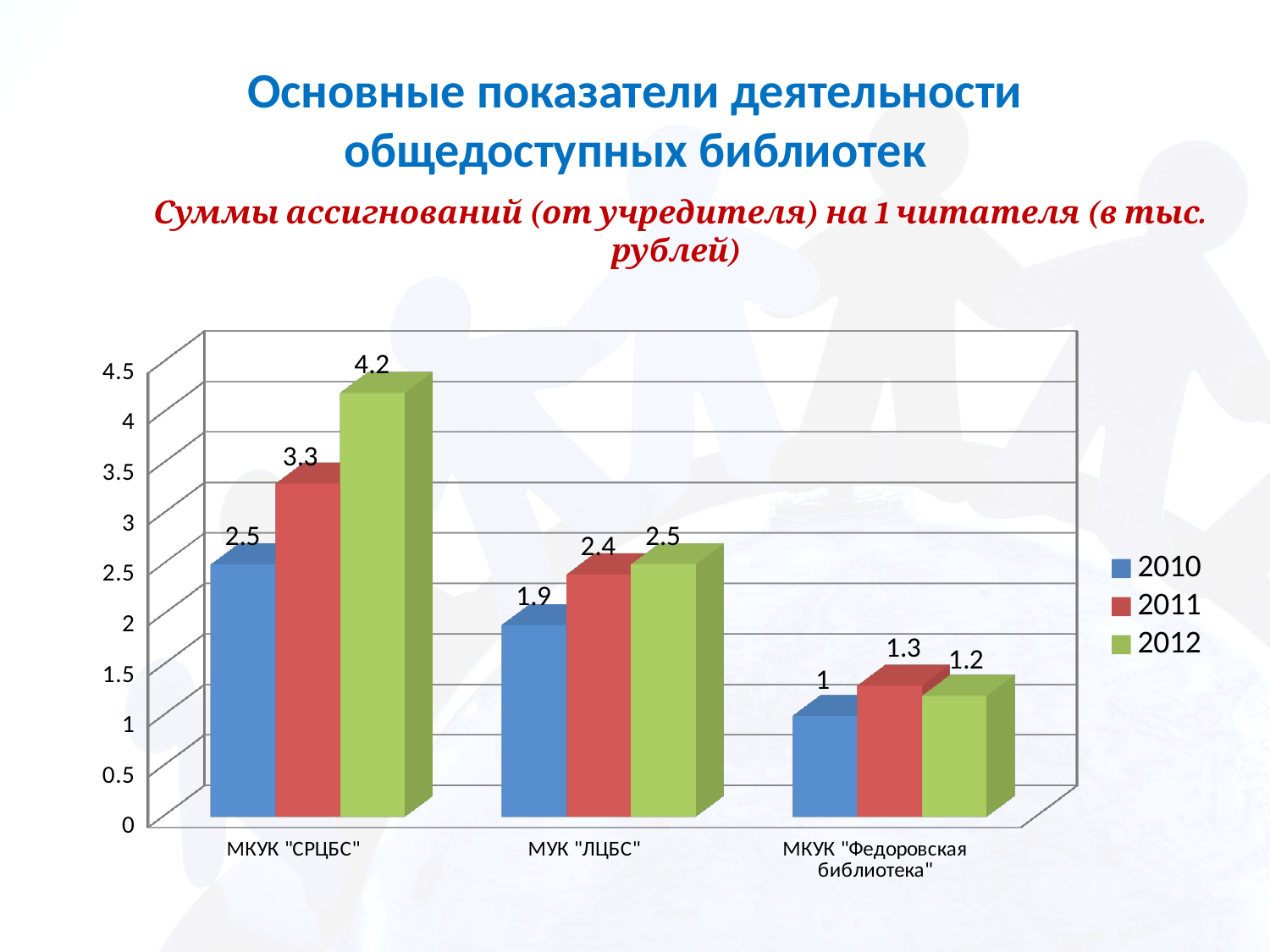
What is the difference between the 2012 and 2010 values for МКУК "СРЦБС"? 1.7 What kind of chart is shown on the slide? bar chart What is the value for МУК "ЛЦБС" in 2010? 1.9 Do the values for МКУК "СРЦБС" rise or fall from 2010 to 2012? rise How many categories are shown on the x axis? 3 What is the value for МКУК "СРЦБС" in 2012? 4.2 Is the 2011 value for МКУК "СРЦБС" greater or less than 3? greater Which category has the highest value in 2012? МКУК "СРЦБС" Which is larger for МКУК "Федоровская библиотека": the 2011 value or the 2012 value? 2011 Which category has the lowest value in 2010? МКУК "Федоровская библиотека" How many series does the legend list? 3 What is the value for МКУК "Федоровская библиотека" in 2011? 1.3